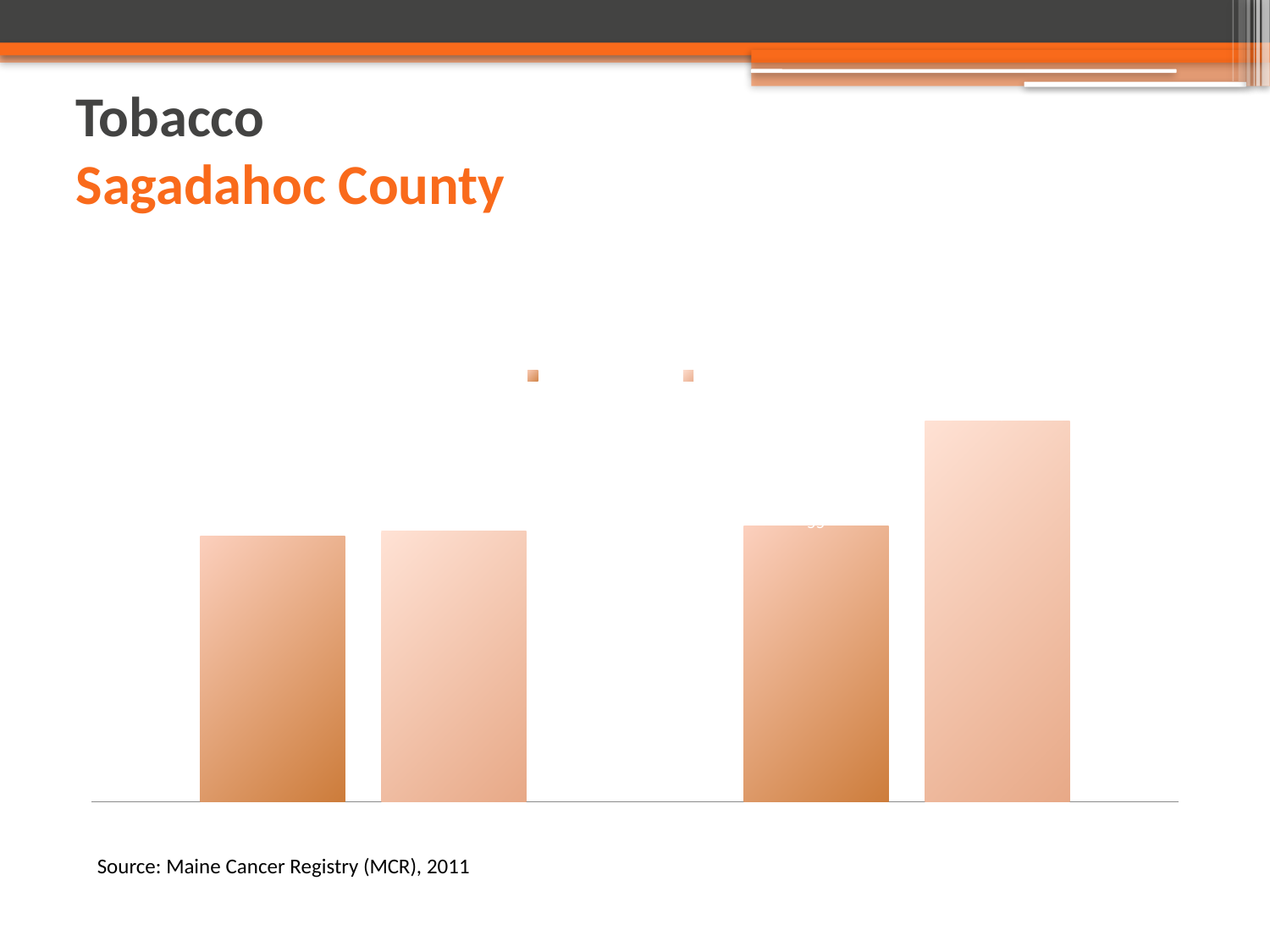
How many groups of bars does the chart show? 2 How many bars are plotted in the chart? 4 How many series does the legend list? 2 What source is cited below the chart? Maine Cancer Registry (MCR), 2011 What county is named in the slide title above the chart? Sagadahoc County Is the rightmost bar taller or shorter than the leftmost bar? taller Which group of bars, left or right, contains the tallest bar? right Which bar is the tallest in the chart? the rightmost bar In the right-hand group of bars, is the darker orange bar or the lighter bar taller? the lighter bar What kind of chart is shown on the slide? bar chart